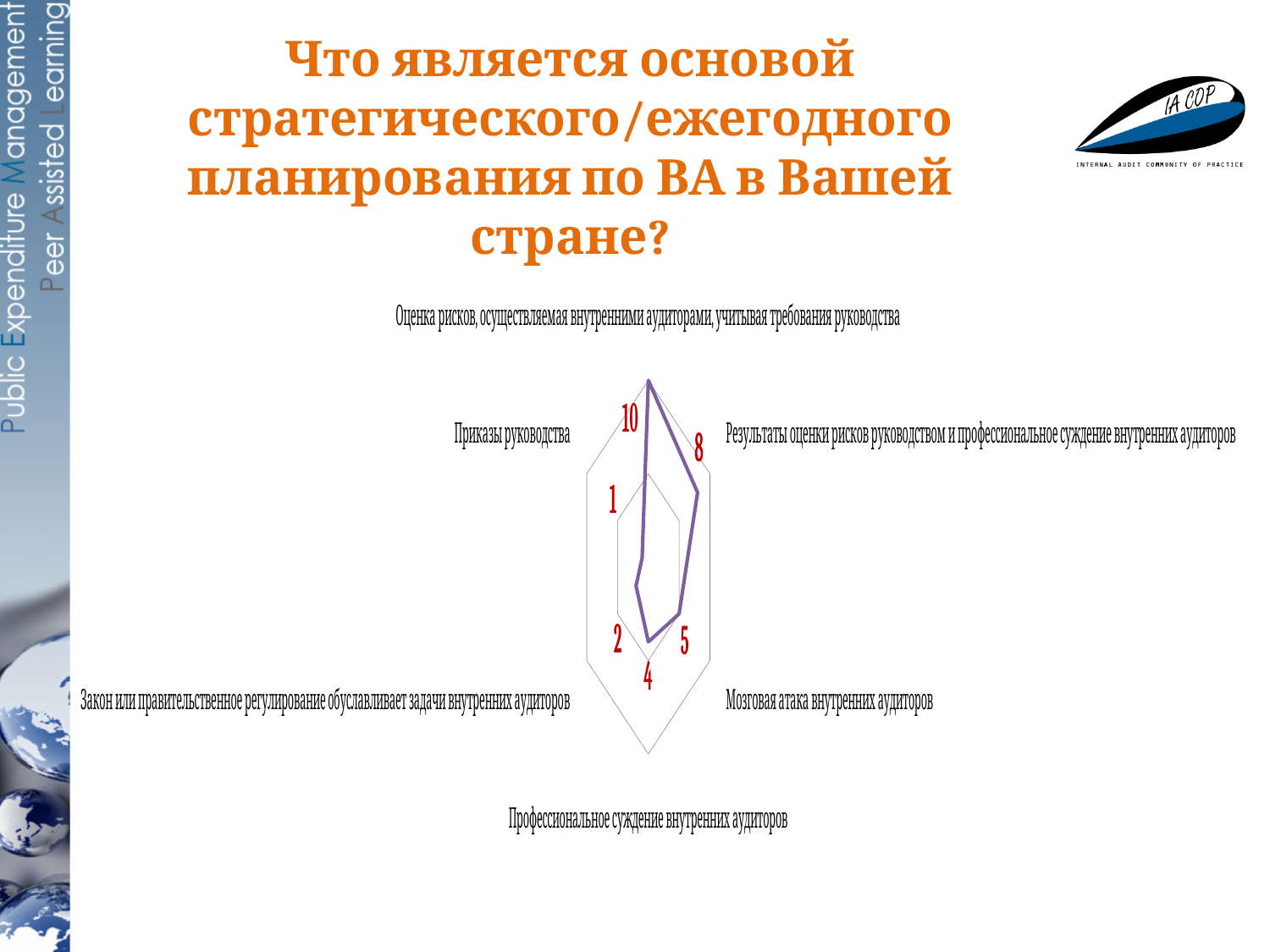
How many categories does the radar chart have? 6 Which category has the highest value? Оценка рисков, осуществляемая внутренними аудиторами, учитывая требования руководства What is the value for "Профессиональное суждение внутренних аудиторов"? 4 What is the value for "Оценка рисков, осуществляемая внутренними аудиторами, учитывая требования руководства"? 10 Which category has the lowest value? Приказы руководства Which is larger: the value for "Мозговая атака внутренних аудиторов" or the value for "Закон или правительственное регулирование обуславливает задачи внутренних аудиторов"? Мозговая атака внутренних аудиторов What is the value for "Приказы руководства"? 1 What kind of chart is shown on the slide? radar chart What is the value for "Мозговая атака внутренних аудиторов"? 5 What is the value for "Закон или правительственное регулирование обуславливает задачи внутренних аудиторов"? 2 What is the difference between the values for "Оценка рисков, осуществляемая внутренними аудиторами, учитывая требования руководства" and "Результаты оценки рисков руководством и профессиональное суждение внутренних аудиторов"? 2 What is the value for "Результаты оценки рисков руководством и профессиональное суждение внутренних аудиторов"? 8